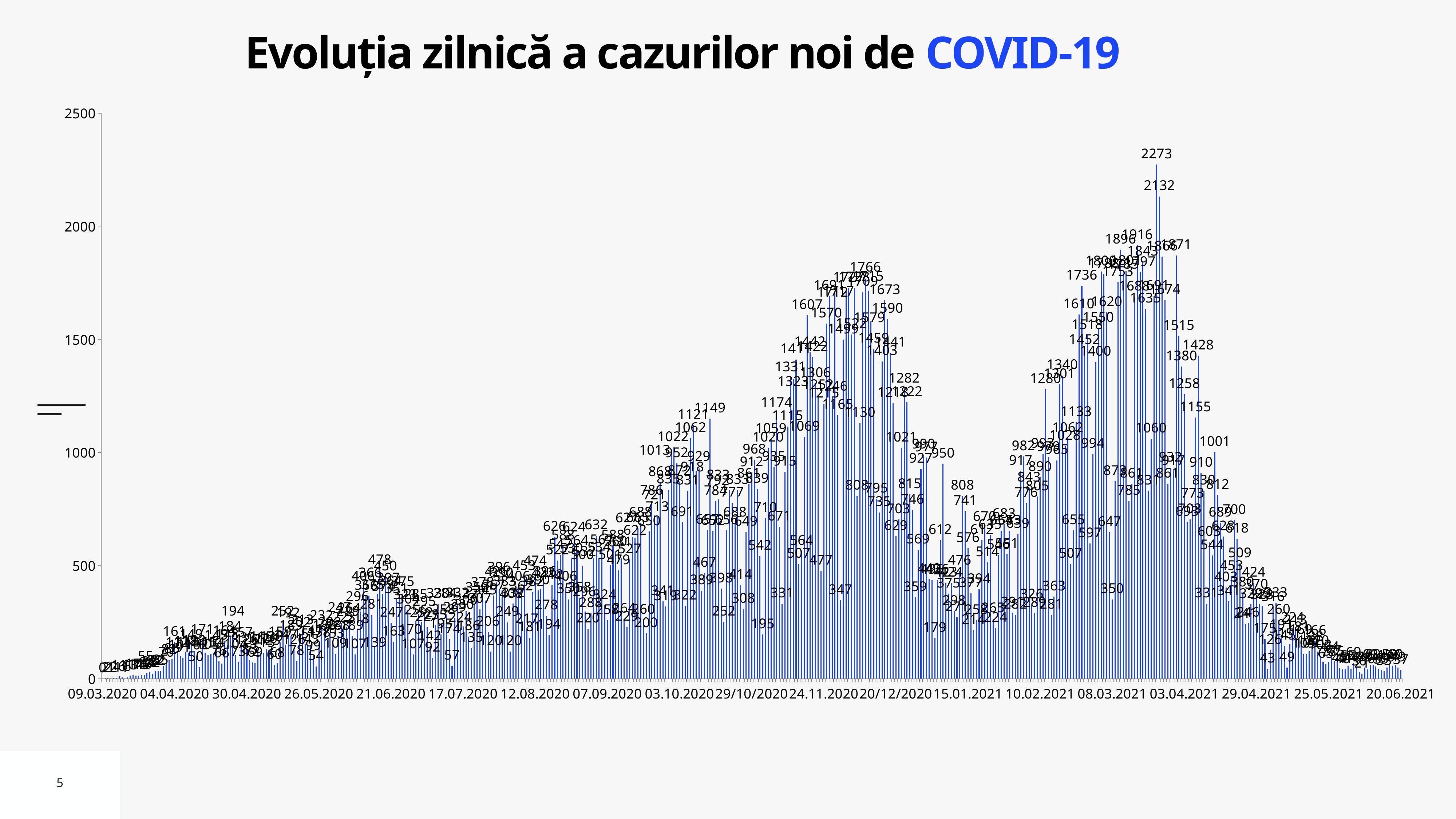
What is the difference between the two highest labelled values, 2273 and 2132? 141 What is the highest tick value shown on the vertical axis? 2500 Are the values at the very start of the chart, around 09.03.2020, greater or less than 500? less What is the highest value labelled on the chart? 2273 What is the last date label shown on the horizontal axis? 20.06.2021 What is the title of the chart? Evoluția zilnică a cazurilor noi de COVID-19 Is the peak of the wave around April 2021 higher or lower than the peak of the wave around December 2020? higher Is the highest peak of the chart greater or less than 2000? greater Do the values rise or fall between 25.05.2021 and 20.06.2021? fall How many date labels are shown along the horizontal axis? 19 What is the second-highest value labelled on the chart, just below the 2273 peak? 2132 What kind of chart is shown on the slide? bar chart